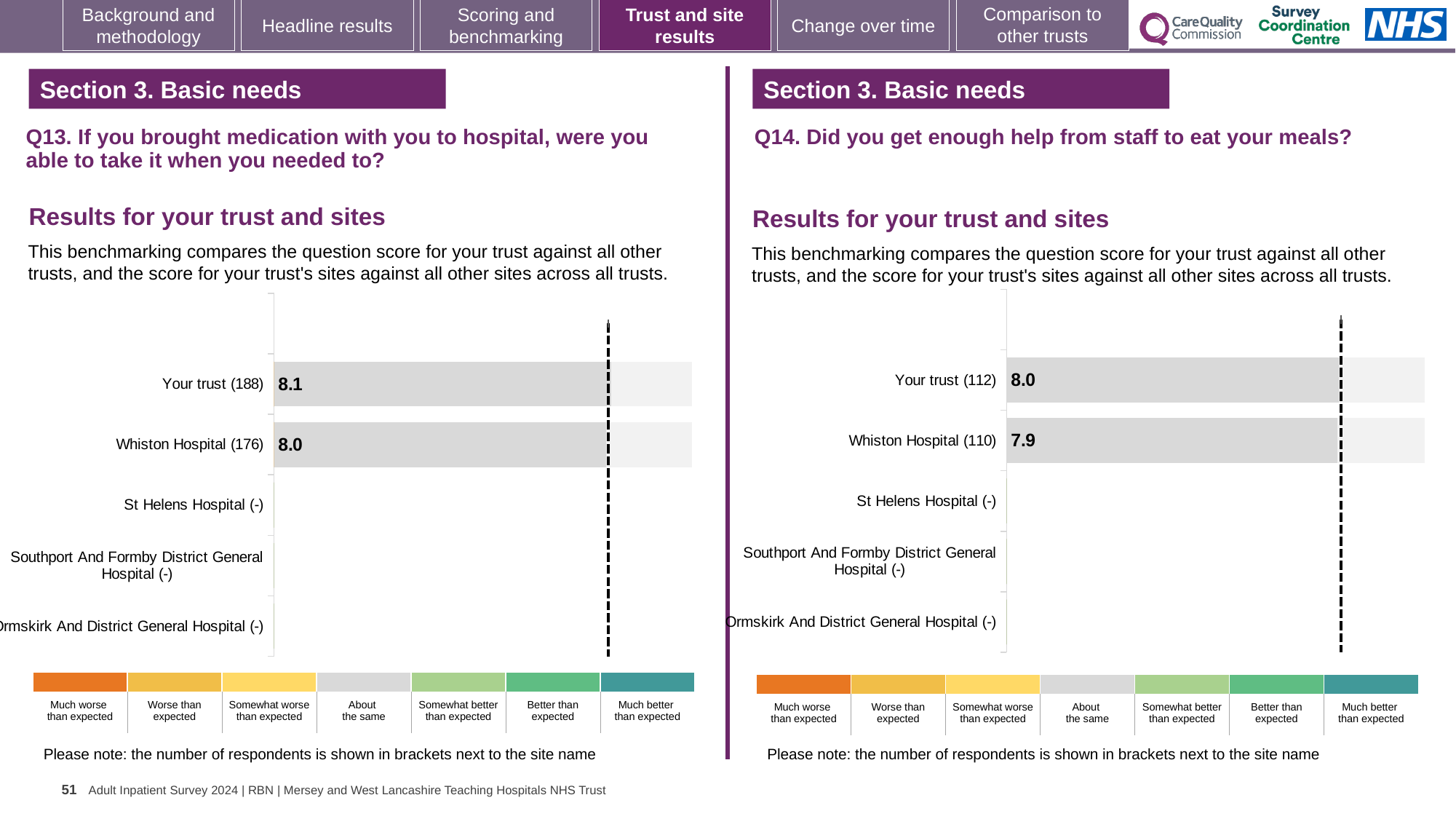
On the Q13 chart (left), which category has the highest score among those with a plotted value? Your trust (188) On the Q13 chart (left), what is the difference between the score for Your trust and the score for Whiston Hospital? 0.1 On the Q14 chart (right), what is the difference between the score for Your trust and the score for Whiston Hospital? 0.1 On the Q13 chart (left), how many respondents are shown in brackets for Your trust? 188 On the Q13 chart (left), what is the score for Your trust? 8.1 On the Q14 chart (right), what is the score for Your trust? 8.0 On the Q14 chart (right), what is the score for Whiston Hospital? 7.9 On the Q13 chart (left), how many site or trust categories are listed on the vertical axis? 5 On the Q13 chart (left), what is the score for Whiston Hospital? 8.0 What kind of chart is used on the Q14 chart (right)? Bar chart On the Q14 chart (right), what is the label of the rightmost colour band in the legend below the chart? Much better than expected On the Q14 chart (right), how many respondents are shown in brackets for Whiston Hospital? 110